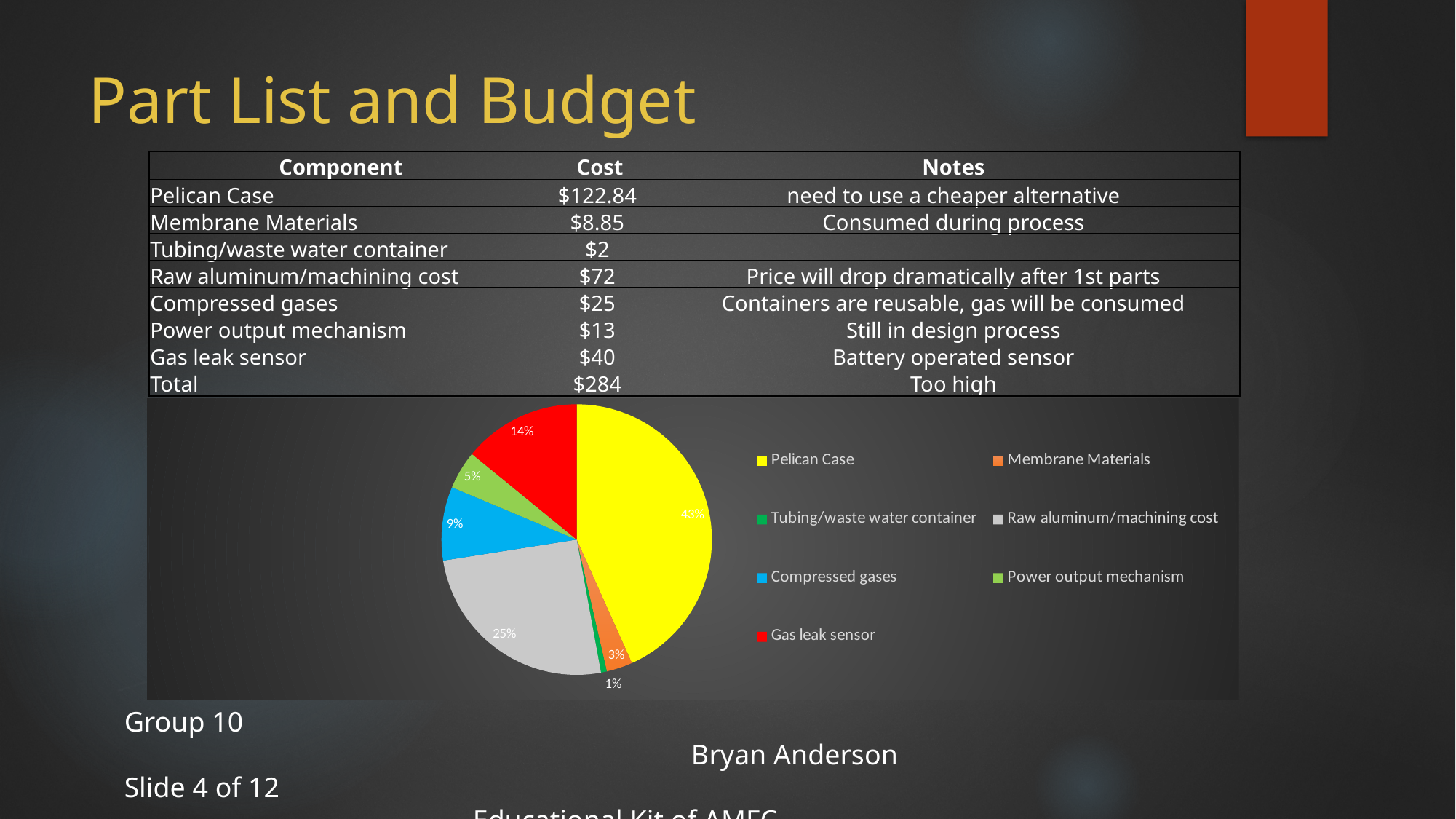
What share of the pie chart does Gas leak sensor take? 14% What kind of chart is shown on the slide? pie chart What share of the pie chart does Pelican Case take? 43% What share of the pie chart does Raw aluminum/machining cost take? 25% Which component has the largest slice of the pie chart? Pelican Case What colour is the Pelican Case slice in the pie chart? yellow Which slice is larger in the pie chart, Gas leak sensor or Compressed gases? Gas leak sensor Which component has the smallest slice of the pie chart? Tubing/waste water container How many components are shown in the pie chart legend? 7